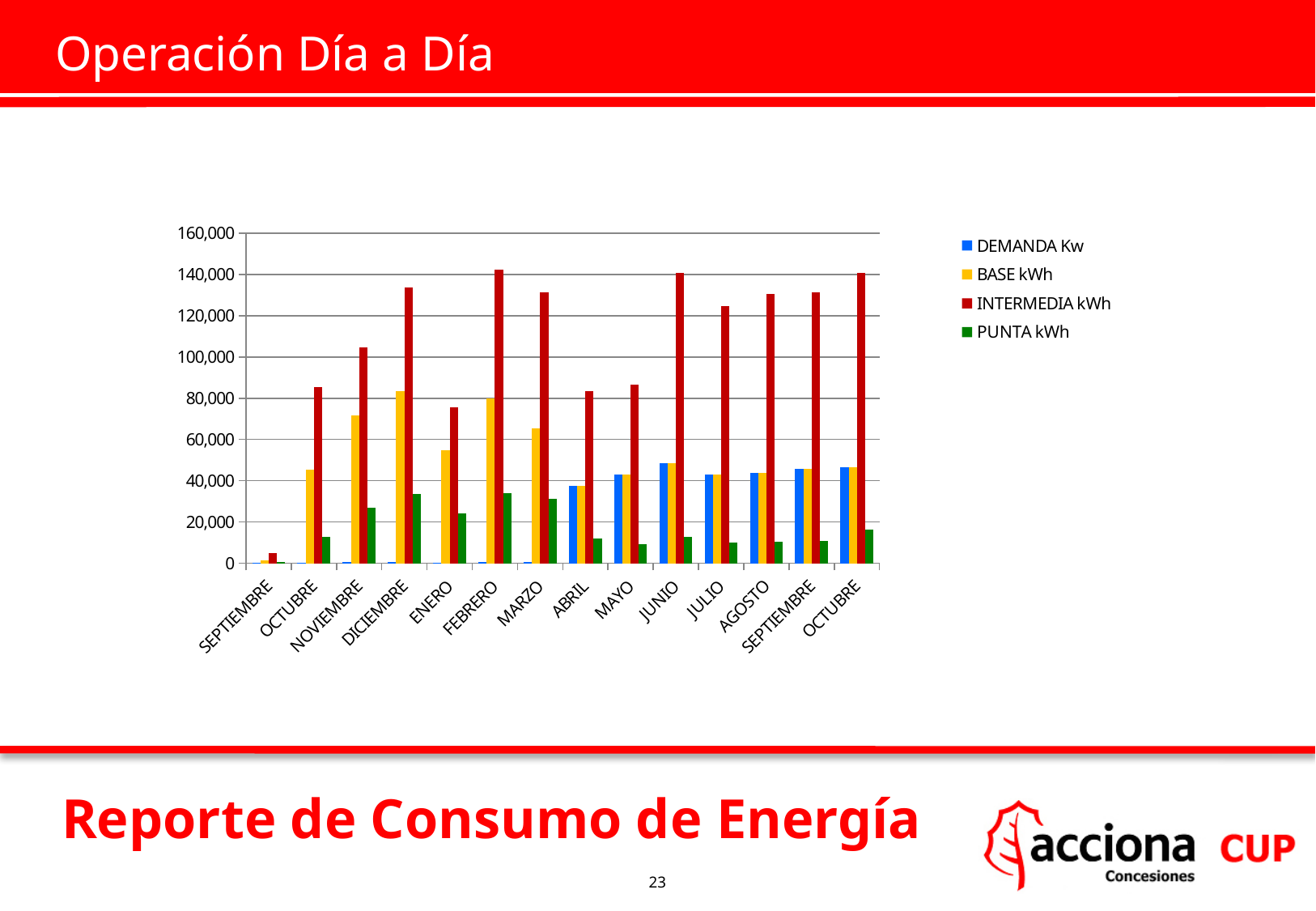
Is the DEMANDA Kw value for JUNIO greater or less than 40,000? greater How many series does the legend list? 4 Which is larger, the INTERMEDIA kWh value for DICIEMBRE or for ENERO? DICIEMBRE Do the INTERMEDIA kWh values rise or fall from the first SEPTIEMBRE to DICIEMBRE? rise What is the highest value shown on the y axis? 160,000 Is the INTERMEDIA kWh value for ENERO greater or less than 80,000? less How many month categories are shown on the x axis? 14 Which is larger, the PUNTA kWh value for NOVIEMBRE or for ABRIL? NOVIEMBRE Is the PUNTA kWh value for DICIEMBRE greater or less than 20,000? greater Which month has the lowest INTERMEDIA kWh value? SEPTIEMBRE (first) What kind of chart is shown on the slide? Bar chart